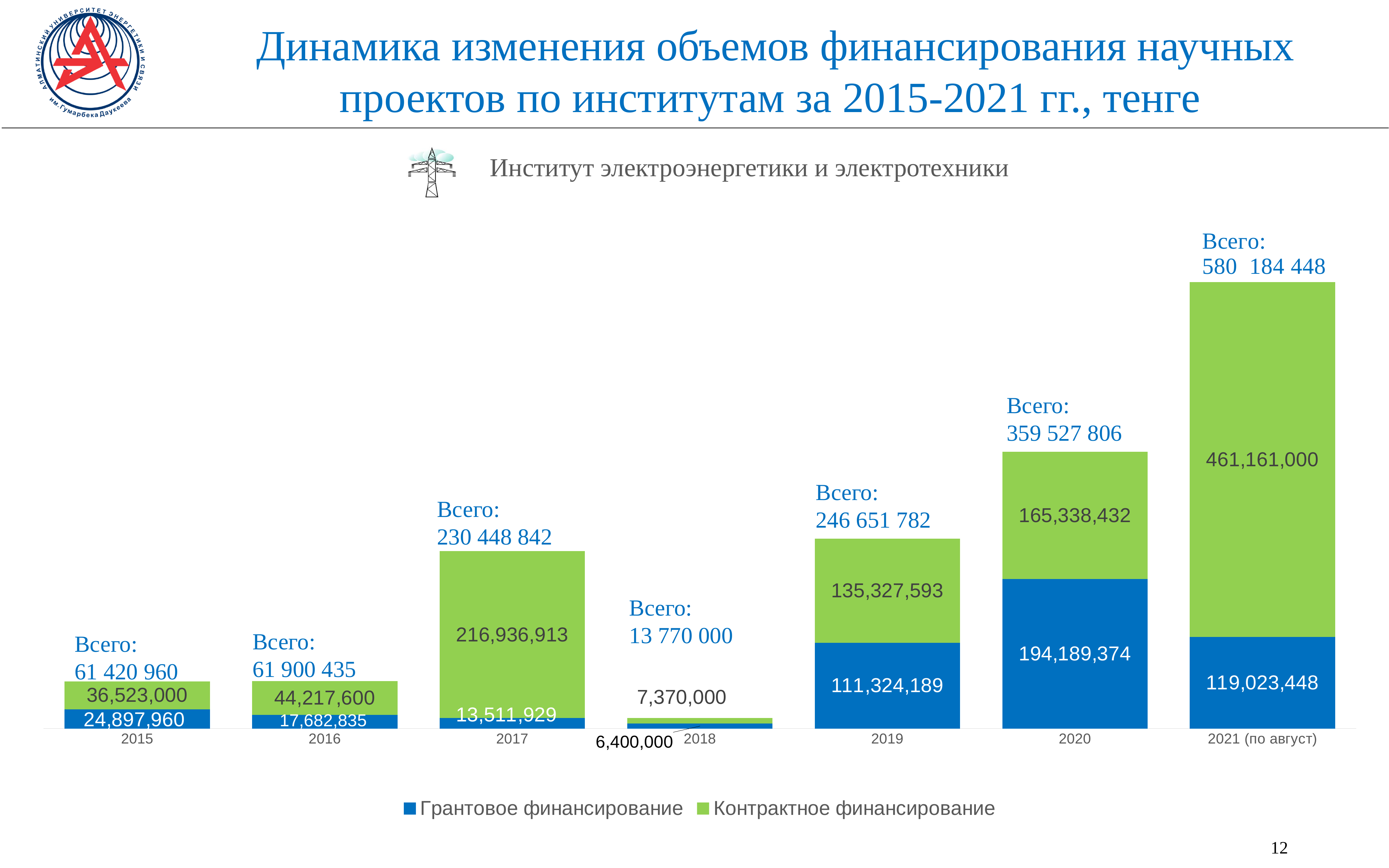
How many series does the legend list? 2 Which institute is named above the chart? Институт электроэнергетики и электротехники What is the value of Грантовое финансирование for 2018? 6,400,000 What is the value of Грантовое финансирование for 2019? 111,324,189 What is the difference between Грантовое финансирование and Контрактное финансирование in 2020? 28,850,942 What kind of chart is shown on the slide? Stacked bar chart What is the value of Контрактное финансирование for 2017? 216,936,913 How many years are shown on the x axis? 7 Which year has the lowest value of Грантовое финансирование? 2018 What is the total (Всего) for 2019? 246 651 782 Which year has the highest value of Контрактное финансирование? 2021 (по август) In 2020, which is larger: Грантовое финансирование or Контрактное финансирование? Грантовое финансирование